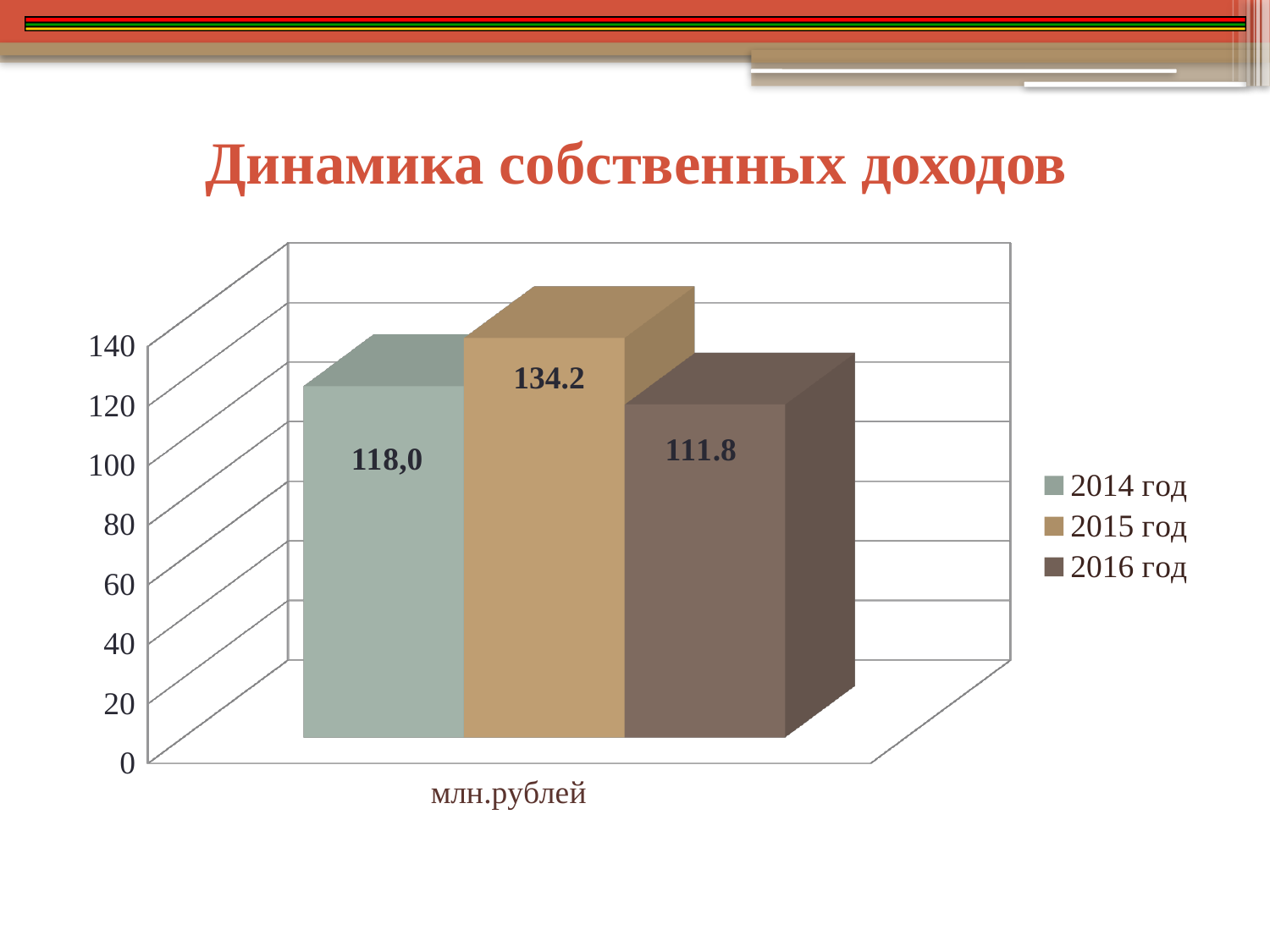
What is the difference between the values for 2015 год and 2016 год? 22.4 What is the title of the chart? Динамика собственных доходов What is the value for 2015 год? 134.2 What is the value for 2016 год? 111.8 What unit label is shown below the bars? млн.рублей What is the value for 2014 год? 118,0 Which year has the lowest value? 2016 год What kind of chart is shown on the slide? bar chart Which is larger, the value for 2014 год or the value for 2016 год? 2014 год Which year has the highest value? 2015 год How many series does the legend list? 3 Is the value for 2015 год greater or less than 120? greater